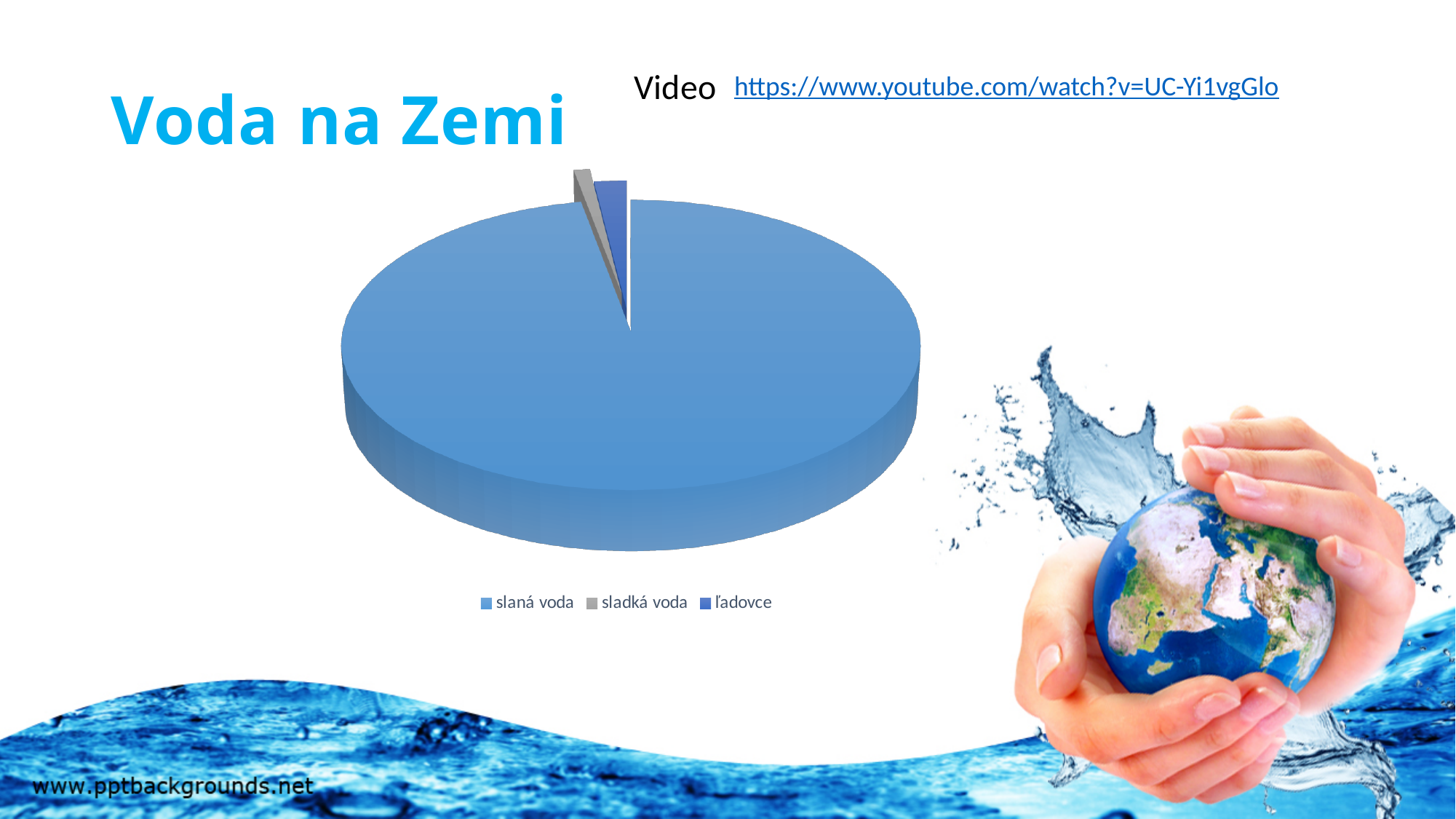
Which category has the largest slice in the pie chart? slaná voda What kind of chart is shown on the slide? pie chart How many entries does the legend of the pie chart list? 3 What colour is the slice for sladká voda in the pie chart? gray What are the three legend entries of the pie chart? slaná voda, sladká voda, ľadovce Which slice is larger, slaná voda or sladká voda? slaná voda Which slice is larger, slaná voda or ľadovce? slaná voda How many slices does the pie chart have? 3